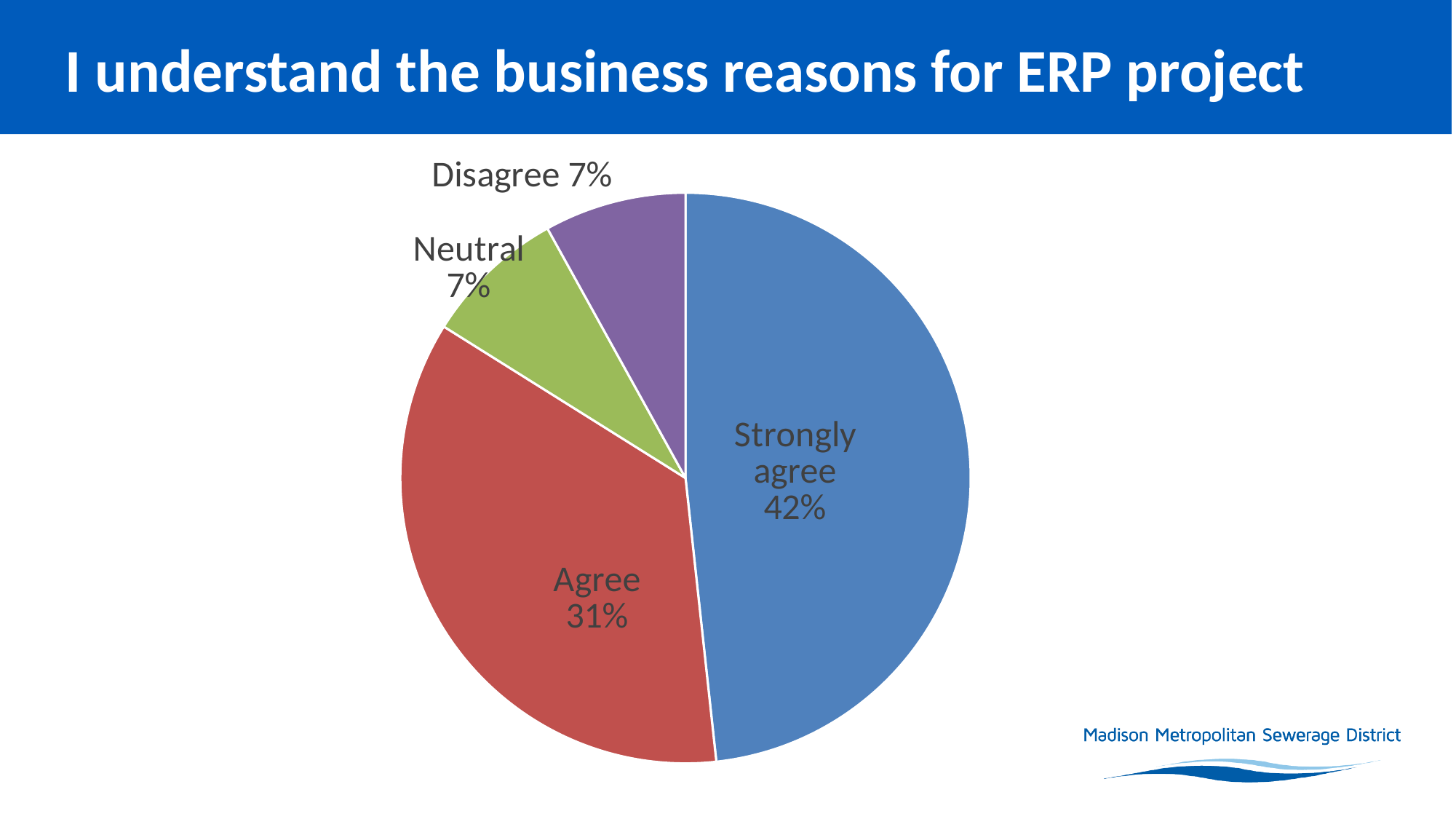
What is the title of the slide containing the chart? I understand the business reasons for ERP project What percentage of respondents chose "Strongly agree"? 42% What colour is the "Agree" slice? Red What percentage of respondents chose "Neutral"? 7% Which response category has the largest share of the pie? Strongly agree What is the difference in percentage points between "Strongly agree" and "Agree"? 11 How many slices does the pie chart have? 4 What percentage of respondents chose "Agree"? 31% Which is larger, the share for "Agree" or the share for "Neutral"? Agree What type of chart is shown on the slide? Pie chart What is the combined share of "Strongly agree" and "Agree"? 73% What percentage of respondents chose "Disagree"? 7%